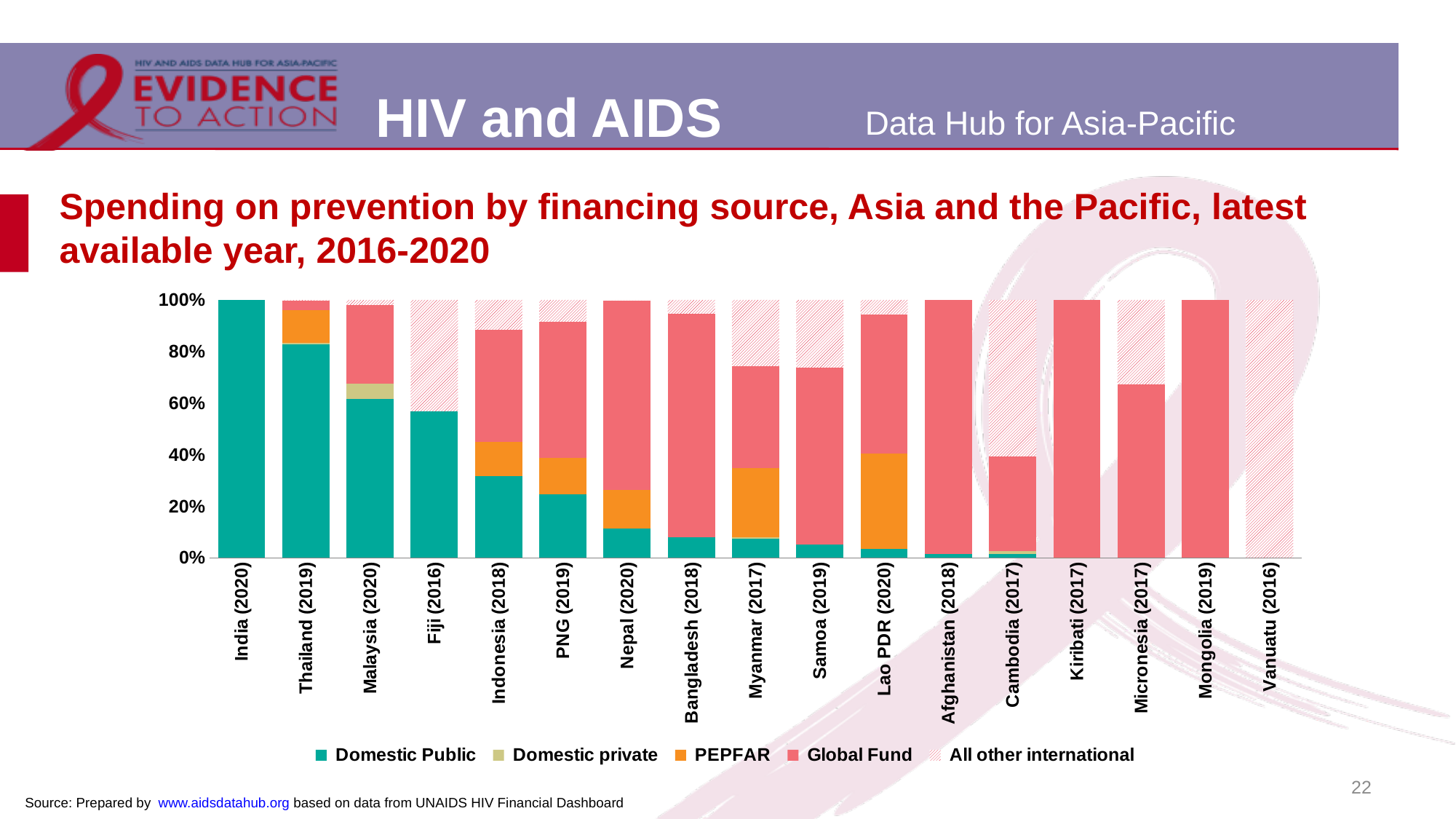
Is the Domestic Public share for India (2020) greater or less than 80%? greater Which financing sources are listed in the chart legend? Domestic Public, Domestic private, PEPFAR, Global Fund, All other international What kind of chart is shown on the slide? Stacked bar chart Is the Domestic Public share for Indonesia (2018) greater or less than 40%? less Is the Domestic Public share for Nepal (2020) greater or less than 20%? less How many countries are shown on the x axis of the chart? 17 Which has the larger PEPFAR share, Lao PDR (2020) or Myanmar (2017)? Lao PDR (2020) How many financing sources does the legend list? 5 Which country has the highest Domestic Public share of prevention spending? India (2020) Which has the larger Domestic Public share, Indonesia (2018) or PNG (2019)? Indonesia (2018) What is the title of the chart? Spending on prevention by financing source, Asia and the Pacific, latest available year, 2016-2020